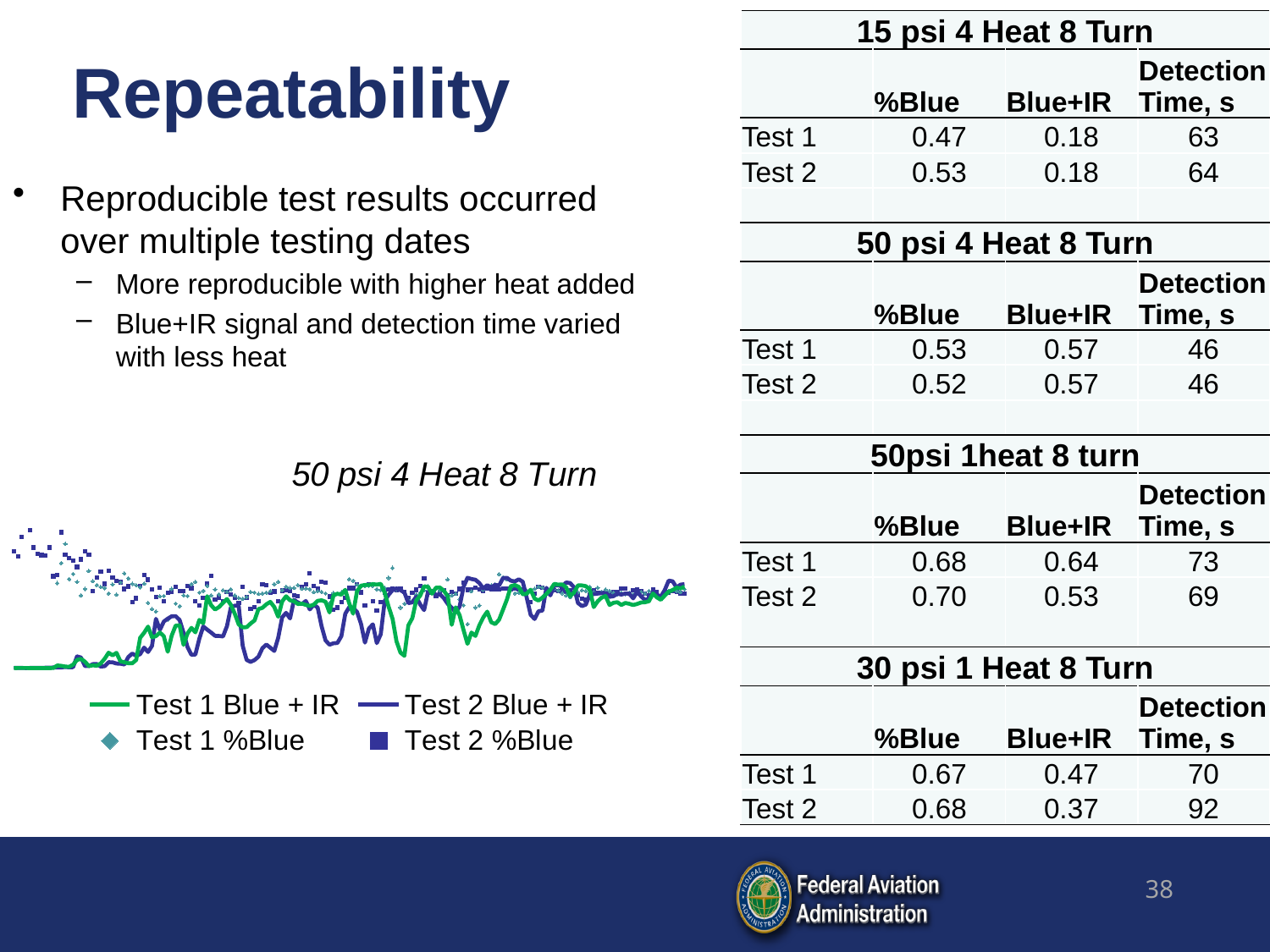
What kind of chart is shown on the slide? line chart What is the title of the chart? 50 psi 4 Heat 8 Turn Do the Test 2 %Blue points rise or fall along the x axis? fall What colour is the Test 1 Blue + IR line in the chart? green How many series does the legend of the chart list? 4 Does the Test 2 Blue + IR line rise or fall along the x axis? rise Do the Test 1 %Blue points rise or fall along the x axis? fall